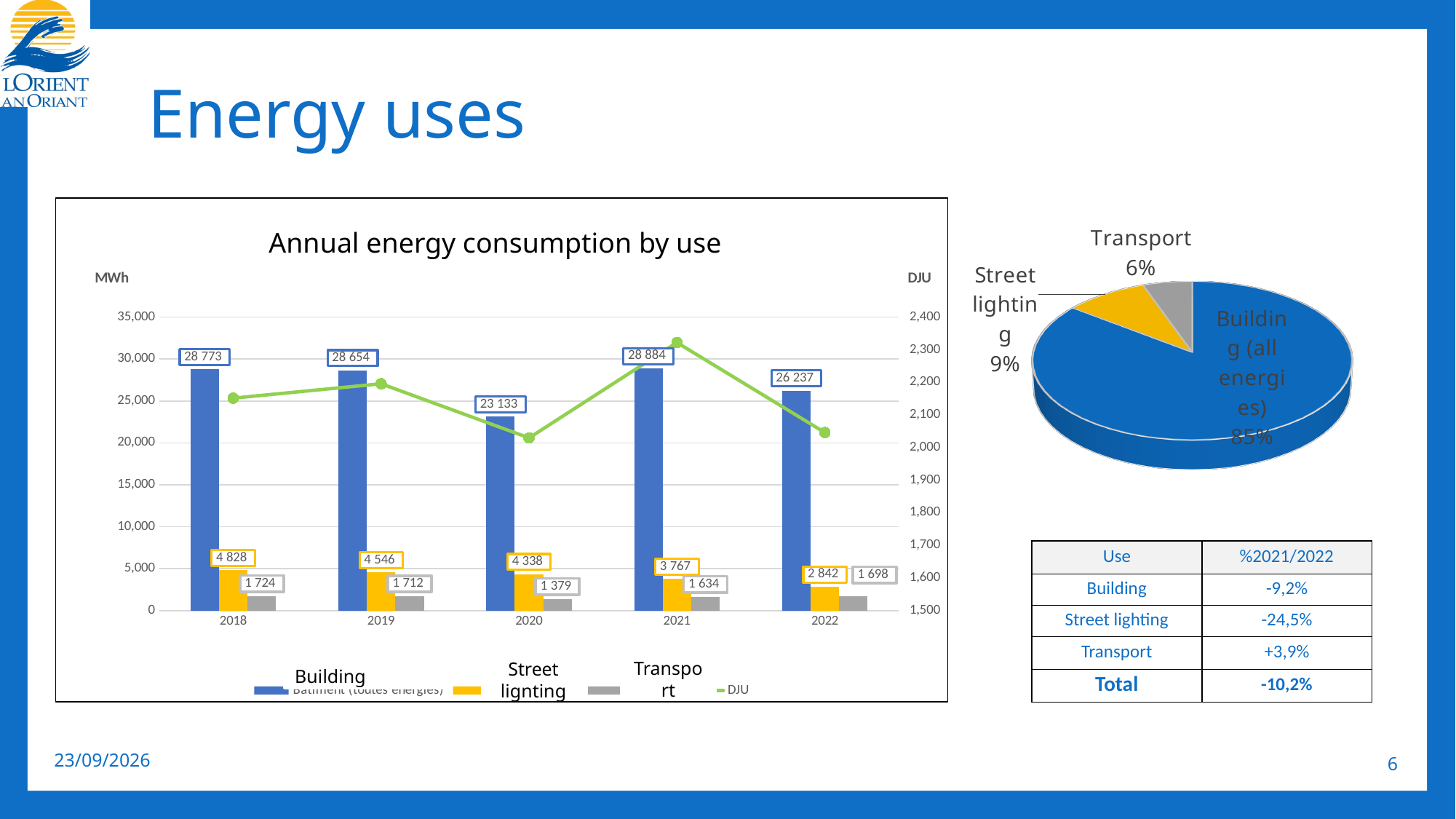
In the 'Annual energy consumption by use' chart, what is the difference between the Street lighting values for 2018 and 2022? 1 986 In the 'Annual energy consumption by use' chart, which year has the larger Transport value, 2018 or 2021? 2018 How many series does the legend of the 'Annual energy consumption by use' chart list? 4 How many years are shown on the x axis of the 'Annual energy consumption by use' chart? 5 In the 'Annual energy consumption by use' chart, what is the Street lighting value for 2022? 2 842 In the 'Annual energy consumption by use' chart, which year has the highest Building value? 2021 In the 'Annual energy consumption by use' chart, what is the Building value for 2021? 28 884 In the 'Annual energy consumption by use' chart, which year has the lowest Building value? 2020 In the pie chart on the right, what share does Building (all energies) have? 85% In the 'Annual energy consumption by use' chart, is the DJU value for 2021 greater or less than 2,200? greater In the 'Annual energy consumption by use' chart, do the Street lighting values rise or fall from 2018 to 2022? fall In the pie chart on the right, which category has the smallest share? Transport